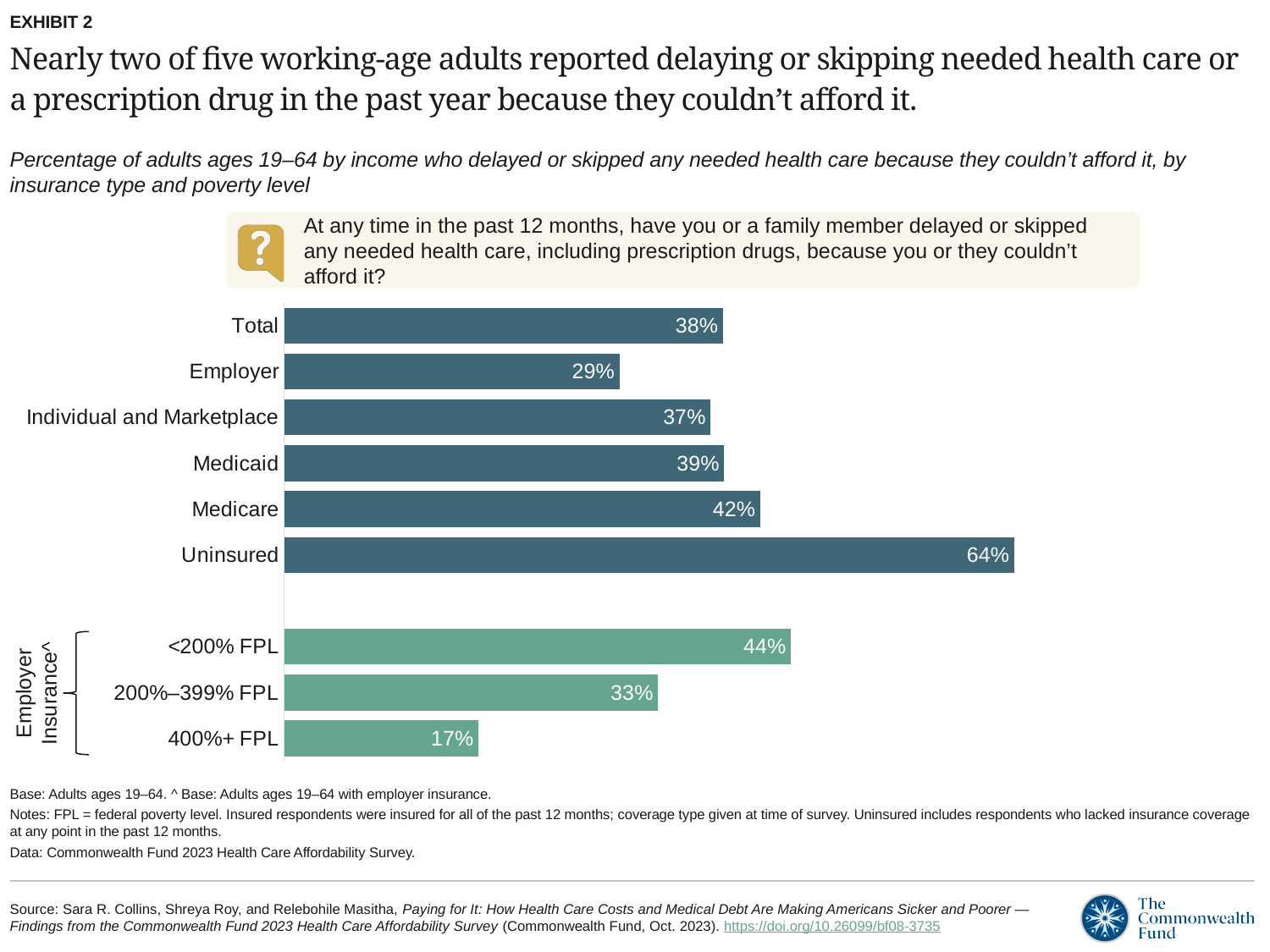
Which category has the highest percentage in the chart? Uninsured Among the employer insurance poverty-level groups, do the values rise or fall as income level increases from <200% FPL to 400%+ FPL? Fall What is the difference in percentage points between the Uninsured bar and the Employer bar? 35 How many bars are plotted in the chart? 9 What is the difference in percentage points between the <200% FPL and 200%–399% FPL bars? 11 What kind of chart is shown on the slide? Bar chart What is the value shown for the Uninsured bar? 64% What is the value shown for the Total bar? 38% Which category has the lowest percentage in the chart? 400%+ FPL What percentage is shown for adults with employer insurance at 400%+ FPL? 17% What percentage of adults with Medicaid delayed or skipped needed health care because they couldn't afford it? 39% Which is larger, the value for Medicare or the value for Individual and Marketplace? Medicare